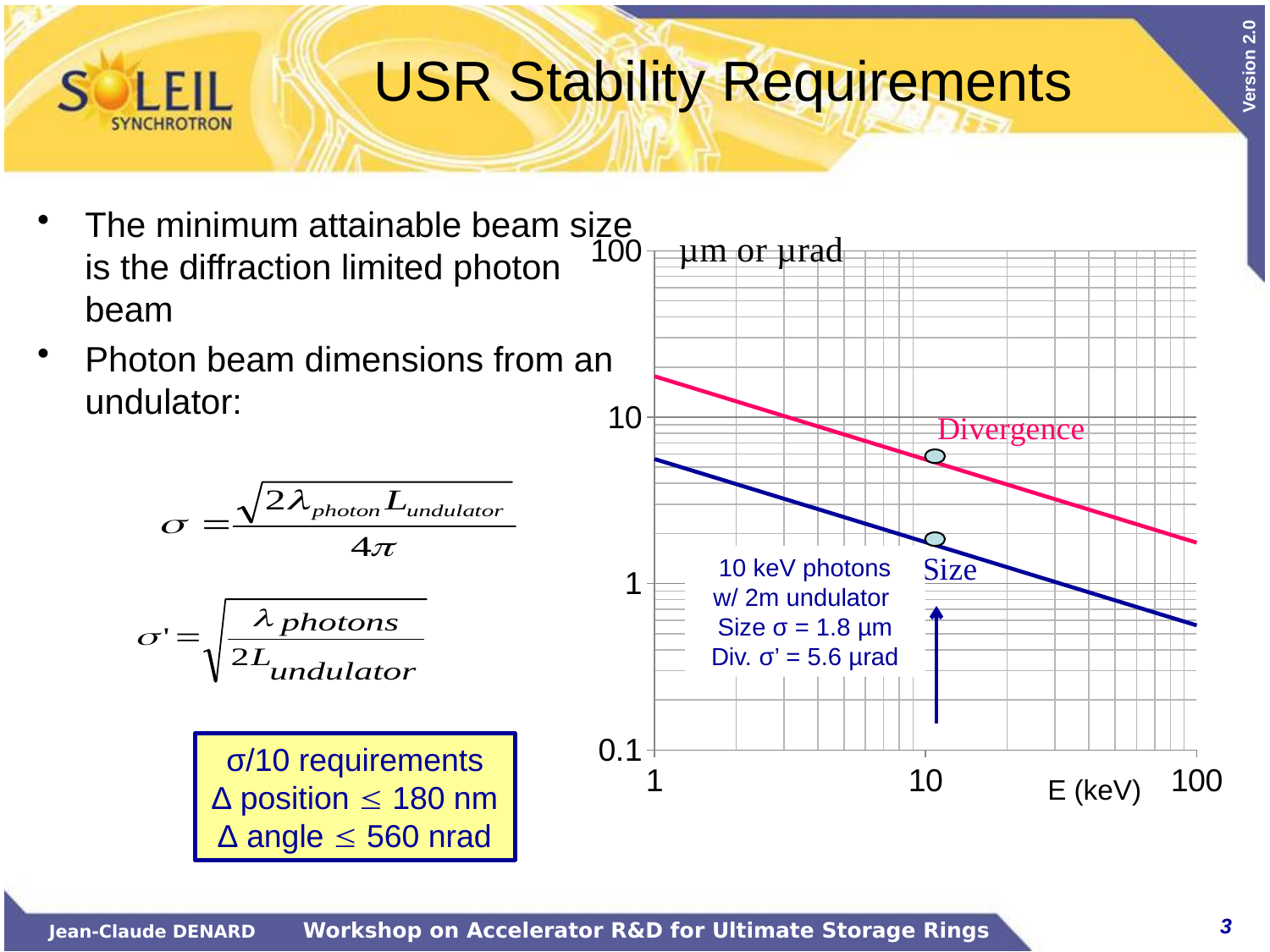
Do the Size and Divergence lines rise or fall as photon energy increases? fall What is the label of the x axis of the chart? E (keV) According to the chart annotation, what is the photon beam divergence at 10 keV with a 2 m undulator? 5.6 µrad Is the Divergence value at 100 keV greater or less than 1? greater How many lines are plotted on the chart? 2 Is the Divergence value at 1 keV greater or less than 10? greater Is the Size value at 100 keV greater or less than 1? less At 10 keV, which is larger in value: the Divergence or the Size? Divergence According to the chart annotation, what is the photon beam size at 10 keV with a 2 m undulator? 1.8 µm What unit label is shown at the top of the y axis of the chart? µm or µrad What kind of chart is shown on the slide? line chart